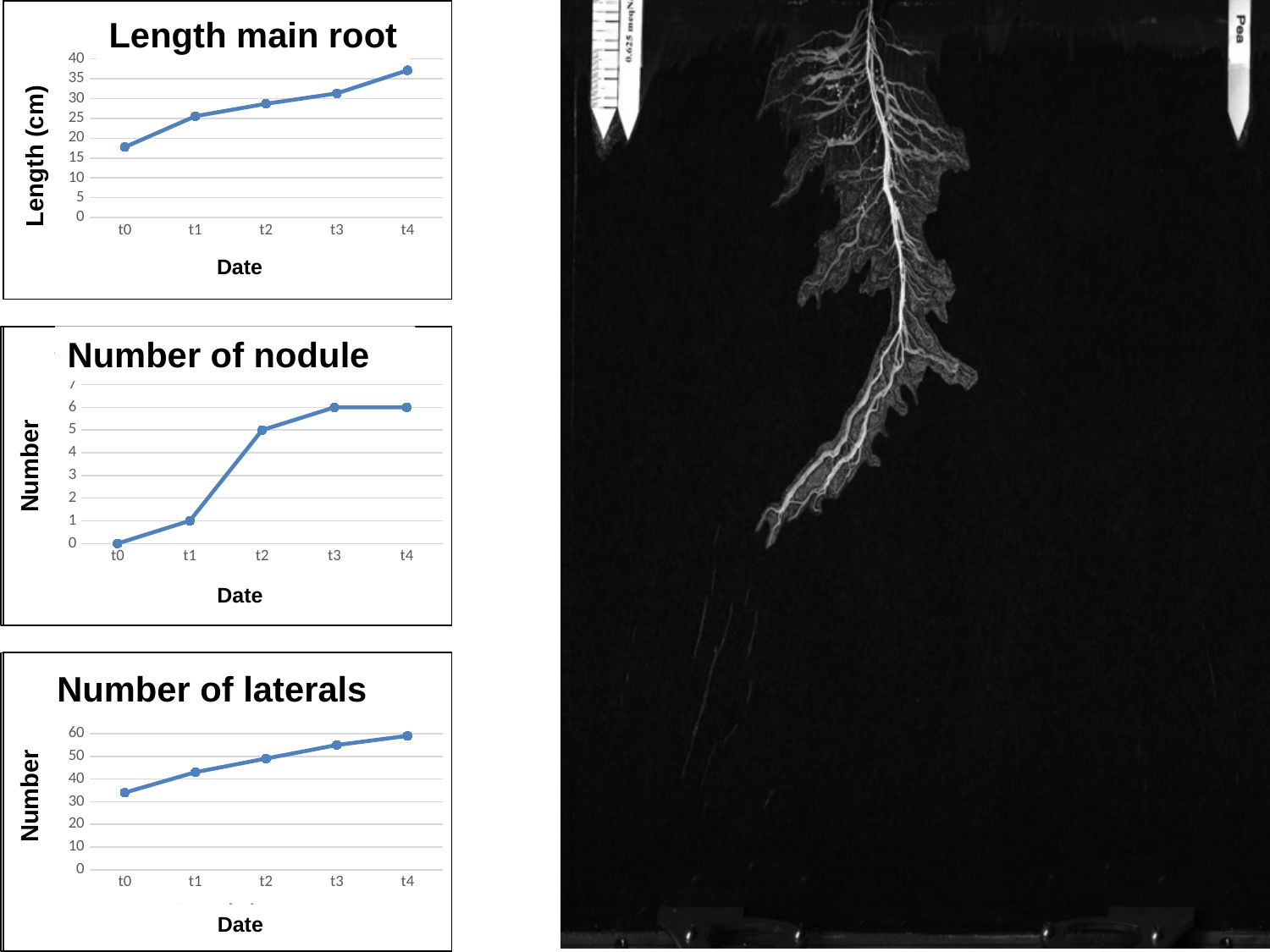
In the "Number of laterals" chart, which date has the highest number of laterals? t4 In the "Number of nodule" chart, what is the number of nodules at t2? 5 In the "Length main root" chart, is the value at t4 greater or less than 35? greater In the "Number of nodule" chart, what is the difference between the values at t2 and t1? 4 In the "Length main root" chart, how many dates are plotted on the x axis? 5 What is the x-axis title of the "Number of laterals" chart? Date In the "Length main root" chart, is the value at t0 greater or less than 20? less In the "Number of nodule" chart, which date has the lowest number of nodules? t0 In the "Length main root" chart, does the length rise or fall from t0 to t4? rise In the "Number of nodule" chart, what is the number of nodules at t0? 0 In the "Number of laterals" chart, is the value at t0 greater or less than 30? greater What type of chart is the "Length main root" chart? line chart